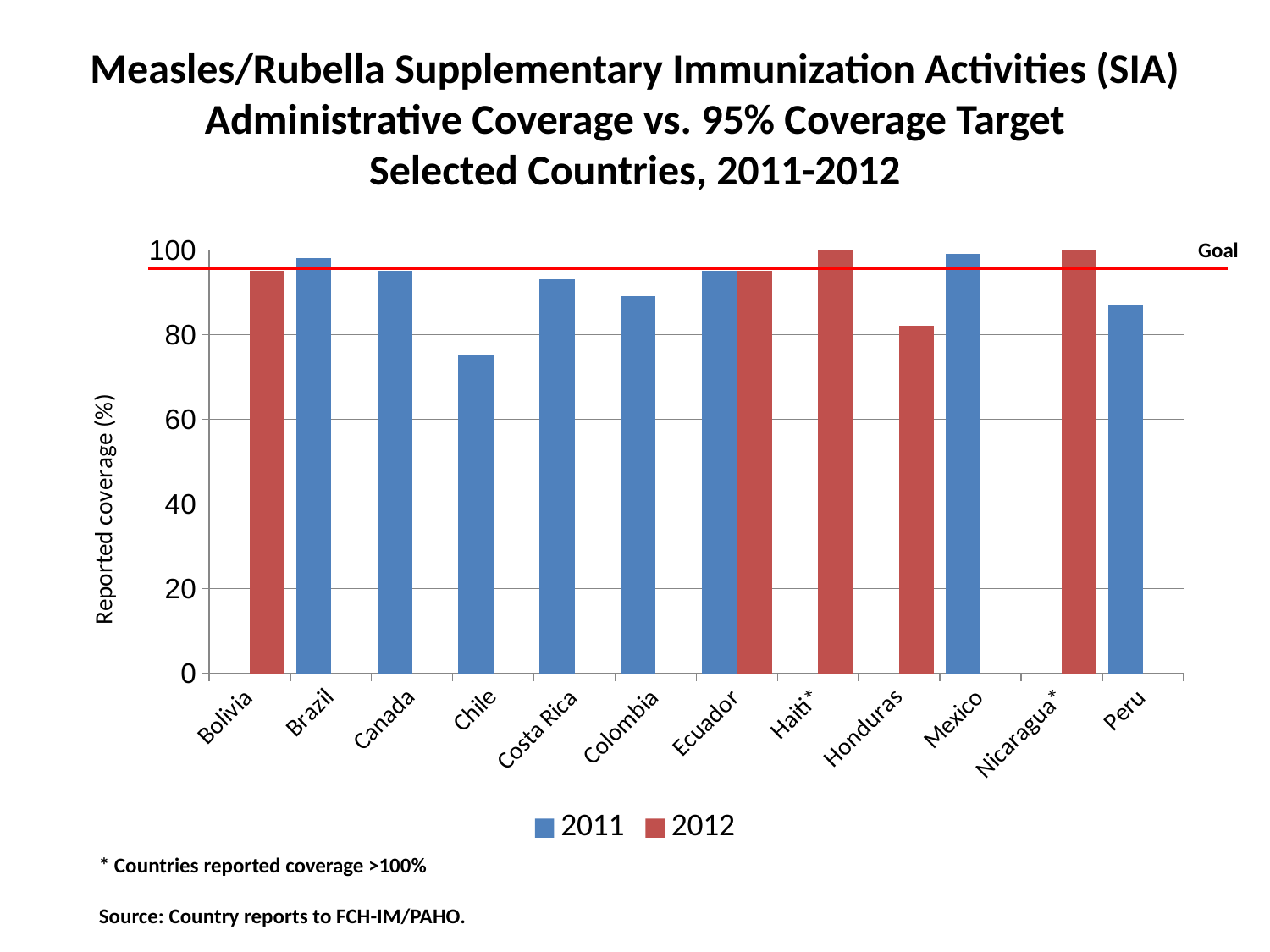
Is the 2011 reported coverage for Peru greater or less than 80? greater Is the 2011 reported coverage for Chile greater or less than 80? less What coverage target does the red horizontal 'Goal' line represent, according to the title? 95% Is the 2012 reported coverage for Honduras greater or less than 80? greater Which is larger, the 2011 coverage for Chile or the 2012 coverage for Honduras? Honduras 2012 Among the 2012 bars, which country has the lowest reported coverage? Honduras Which is larger, the 2011 coverage for Brazil or the 2011 coverage for Peru? Brazil How many countries are shown on the x axis? 12 How many series does the legend list? 2 What kind of chart is shown on the slide? bar chart Which country has the lowest reported coverage bar on the chart? Chile